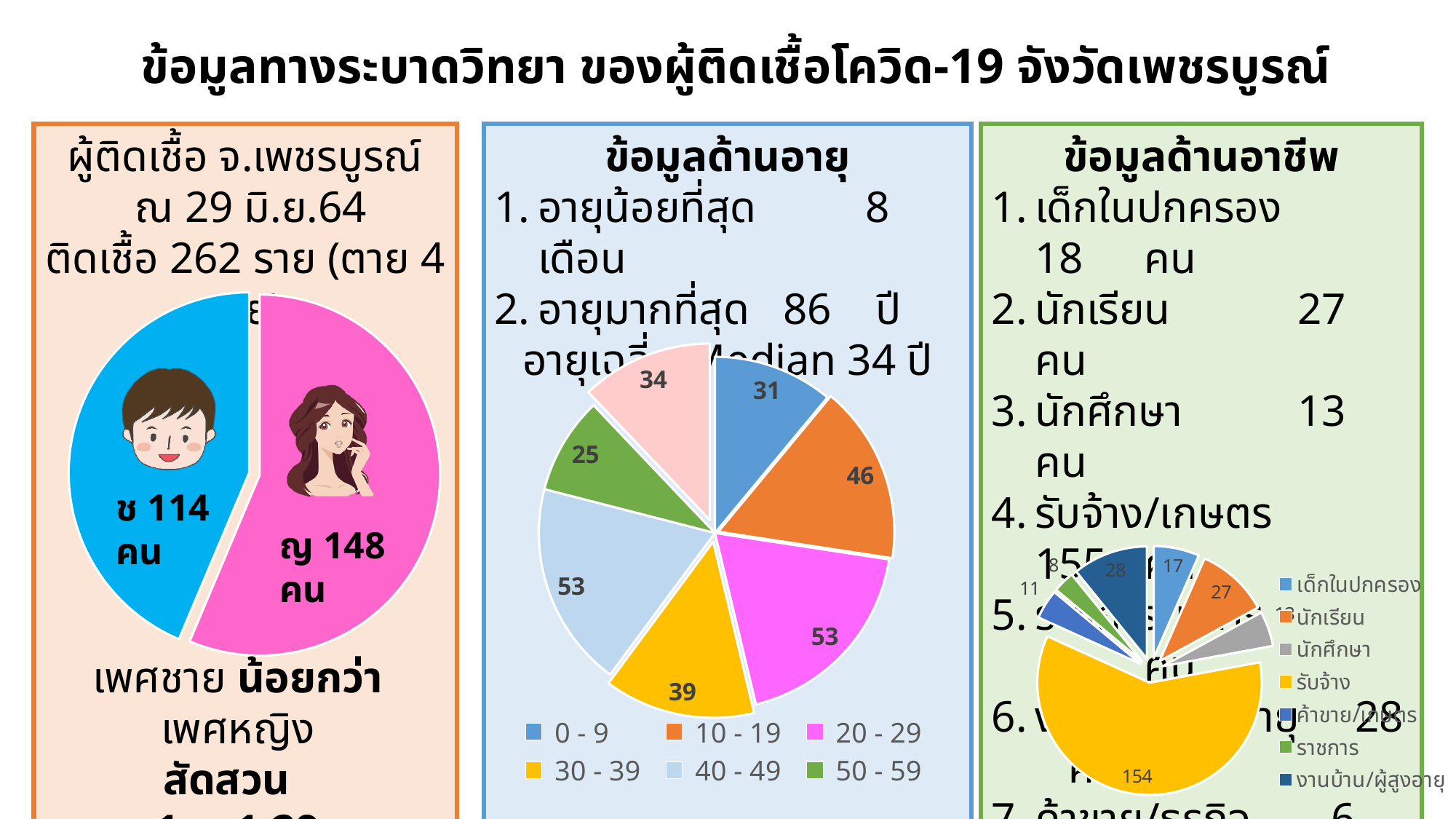
In the left pie chart (gender), which slice is larger, ช or ญ? ญ In the right pie chart (occupation), how many entries does the legend list? 7 In the right pie chart (occupation), which category has the largest value? รับจ้าง In the left pie chart (gender), what is the value for ช (male)? 114 คน In the middle pie chart (age), which legend group has the smallest value? 50 - 59 In the left pie chart (gender), what is the value for ญ (female)? 148 คน What kind of chart is the middle chart under ข้อมูลด้านอายุ? pie chart In the middle pie chart (age), how many slices are there? 7 In the middle pie chart (age), what is the value for the 10 - 19 group? 46 In the middle pie chart (age), what is the value for the 30 - 39 group? 39 In the middle pie chart (age), what is the difference between the 10 - 19 and 0 - 9 values? 15 In the left pie chart (gender), what is the difference between the ญ and ช values? 34